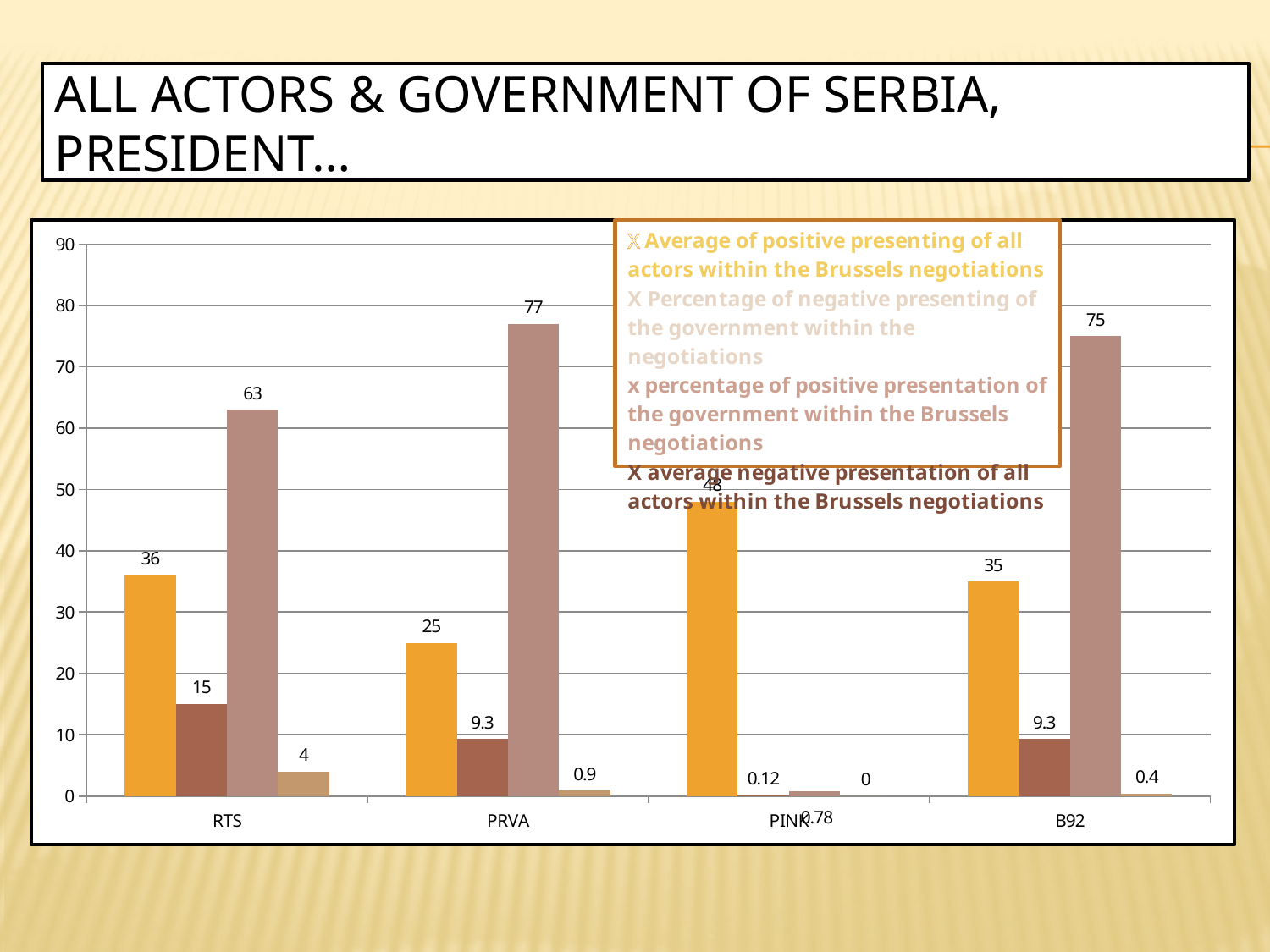
What kind of chart is shown on the slide? bar chart What is the title of the slide? ALL ACTORS & GOVERNMENT OF SERBIA, PRESIDENT... What is the average of positive presenting of all actors within the Brussels negotiations for PINK? 48 How many TV channels (categories) are shown on the x axis? 4 Which channel has the highest percentage of positive presentation of the government within the Brussels negotiations? PRVA How many series does the legend list? 4 Is the percentage of positive presentation of the government for B92 greater or less than 70? greater Which channel has the lowest average of positive presenting of all actors within the Brussels negotiations? PRVA Which is larger: the average of positive presenting of all actors for RTS or for B92? RTS What is the percentage of positive presentation of the government within the Brussels negotiations for PRVA? 77 What is the percentage of negative presenting of the government within the negotiations for RTS? 4 For RTS, what is the difference between the percentage of positive presentation of the government (63) and the average of positive presenting of all actors (36)? 27